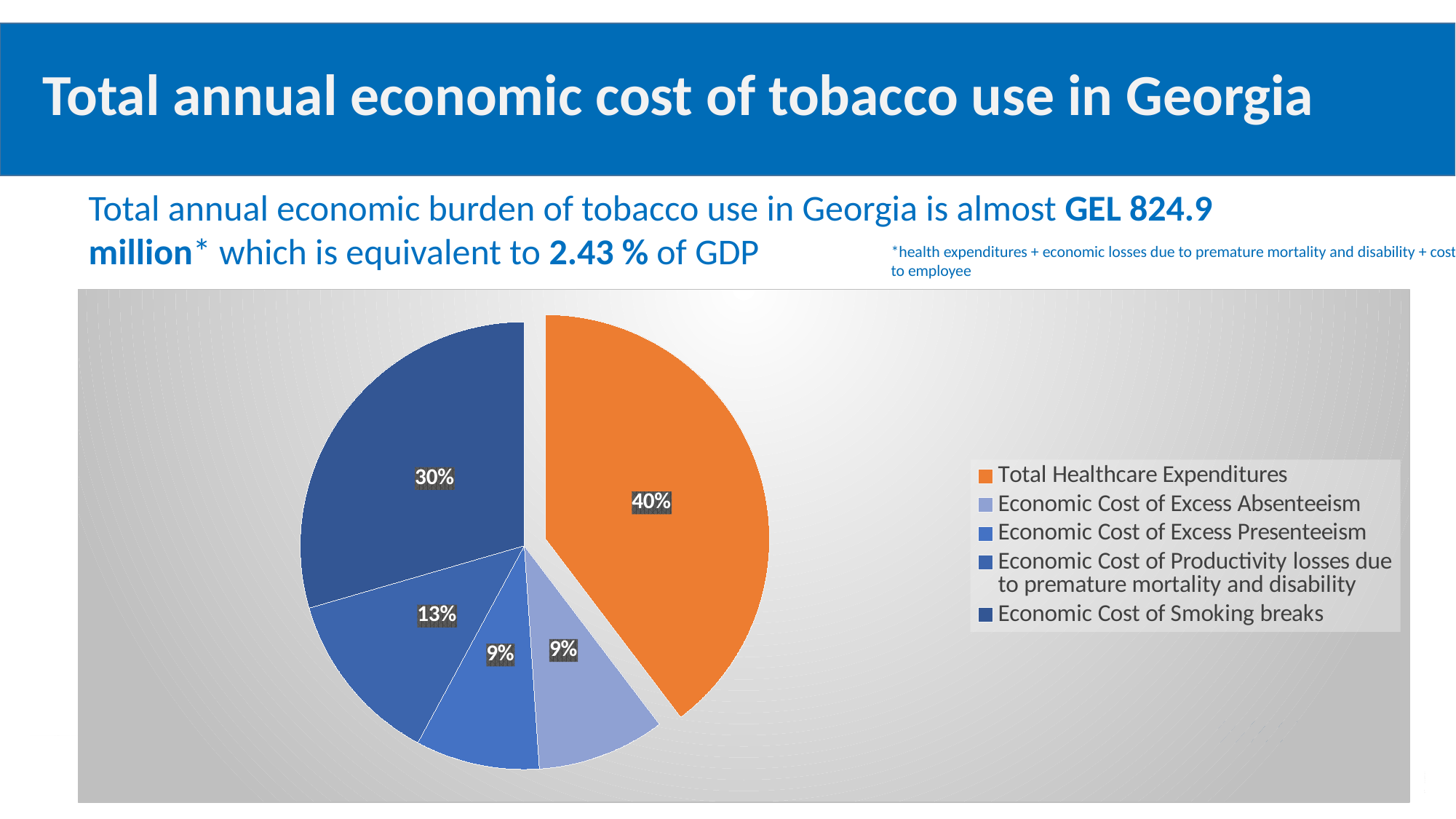
What colour is the Total Healthcare Expenditures slice? orange What kind of chart is shown on the slide? pie chart Which is larger, Economic Cost of Smoking breaks or Economic Cost of Productivity losses due to premature mortality and disability? Economic Cost of Smoking breaks What is the combined share of Economic Cost of Excess Absenteeism and Economic Cost of Excess Presenteeism? 18% What share of the pie is Total Healthcare Expenditures? 40% Which category has the largest slice of the pie? Total Healthcare Expenditures What share of the pie is Economic Cost of Smoking breaks? 30% How many entries does the legend list? 5 What is the difference in percentage points between Total Healthcare Expenditures and Economic Cost of Smoking breaks? 10 How many slices does the pie chart have? 5 What share of the pie is Economic Cost of Productivity losses due to premature mortality and disability? 13% What share of the pie is Economic Cost of Excess Absenteeism? 9%